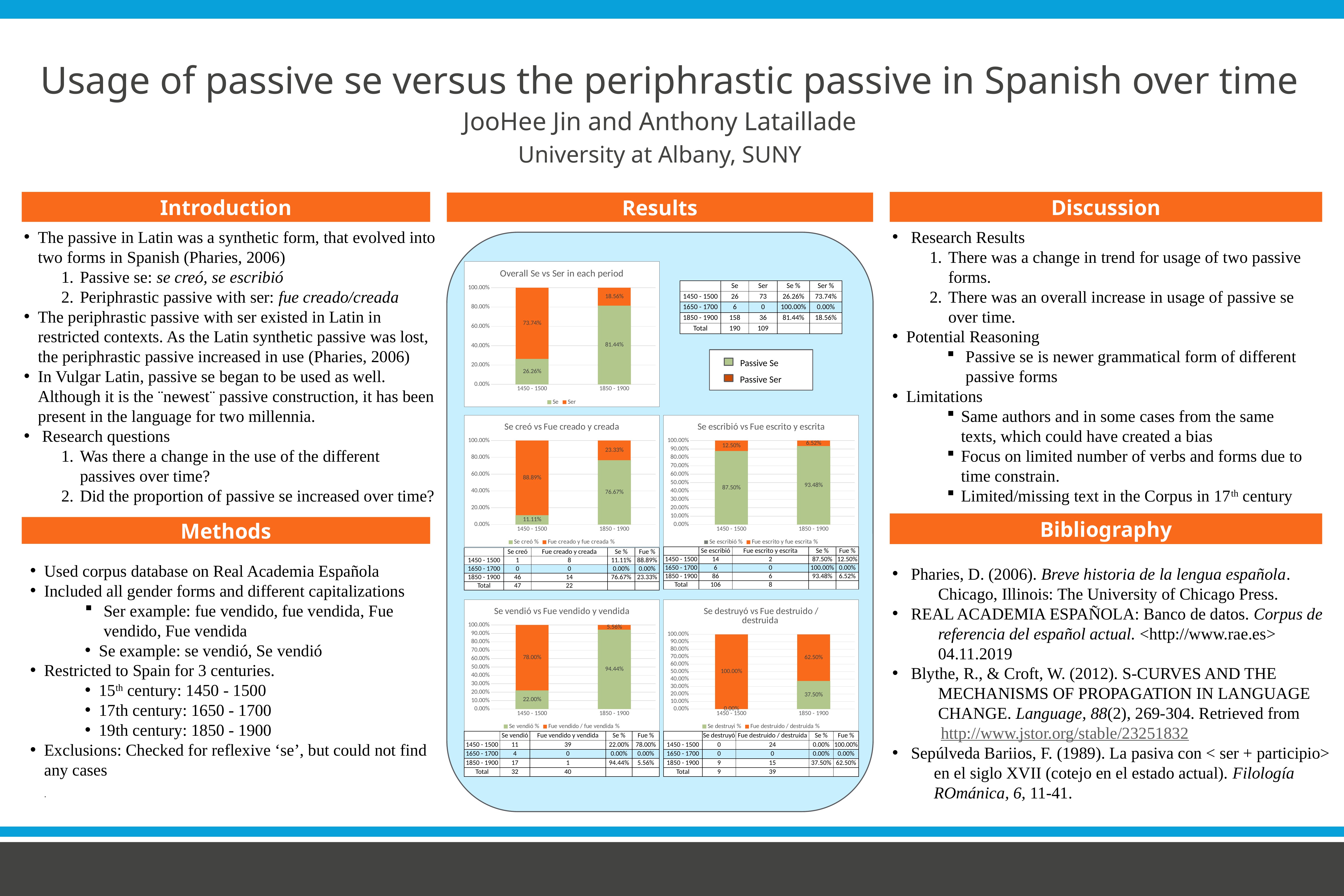
In the 'Se creó vs Fue creado y creada' chart, what is the Se creó % value for 1450 - 1500? 11.11% In the 'Overall Se vs Ser in each period' chart, what is the Se value for 1850 - 1900? 81.44% In the 'Se destruyó vs Fue destruido / destruida' chart, what is the Fue destruido / destruida % value for 1450 - 1500? 100.00% In the 'Se destruyó vs Fue destruido / destruida' chart, is the Se destruyó % value for 1850 - 1900 larger or smaller than the Fue destruido / destruida % value for the same period? Smaller In the 'Se vendió vs Fue vendido y vendida' chart, how many periods are shown on the x axis? 2 In the 'Se creó vs Fue creado y creada' chart, does the Se creó % value rise or fall from 1450 - 1500 to 1850 - 1900? Rise In the 'Overall Se vs Ser in each period' chart, how many series does the legend list? 2 What kind of chart is 'Se creó vs Fue creado y creada'? Stacked bar chart In the 'Se vendió vs Fue vendido y vendida' chart, what is the difference between the Se vendió % values for 1850 - 1900 and 1450 - 1500? 72.44% In the 'Se escribió vs Fue escrito y escrita' chart, what is the Fue escrito y fue escrita % value for 1850 - 1900? 6.52% In the 'Se escribió vs Fue escrito y escrita' chart, which period has the higher Se escribió % value? 1850 - 1900 In the 'Overall Se vs Ser in each period' chart, what is the Ser value for 1450 - 1500? 73.74%